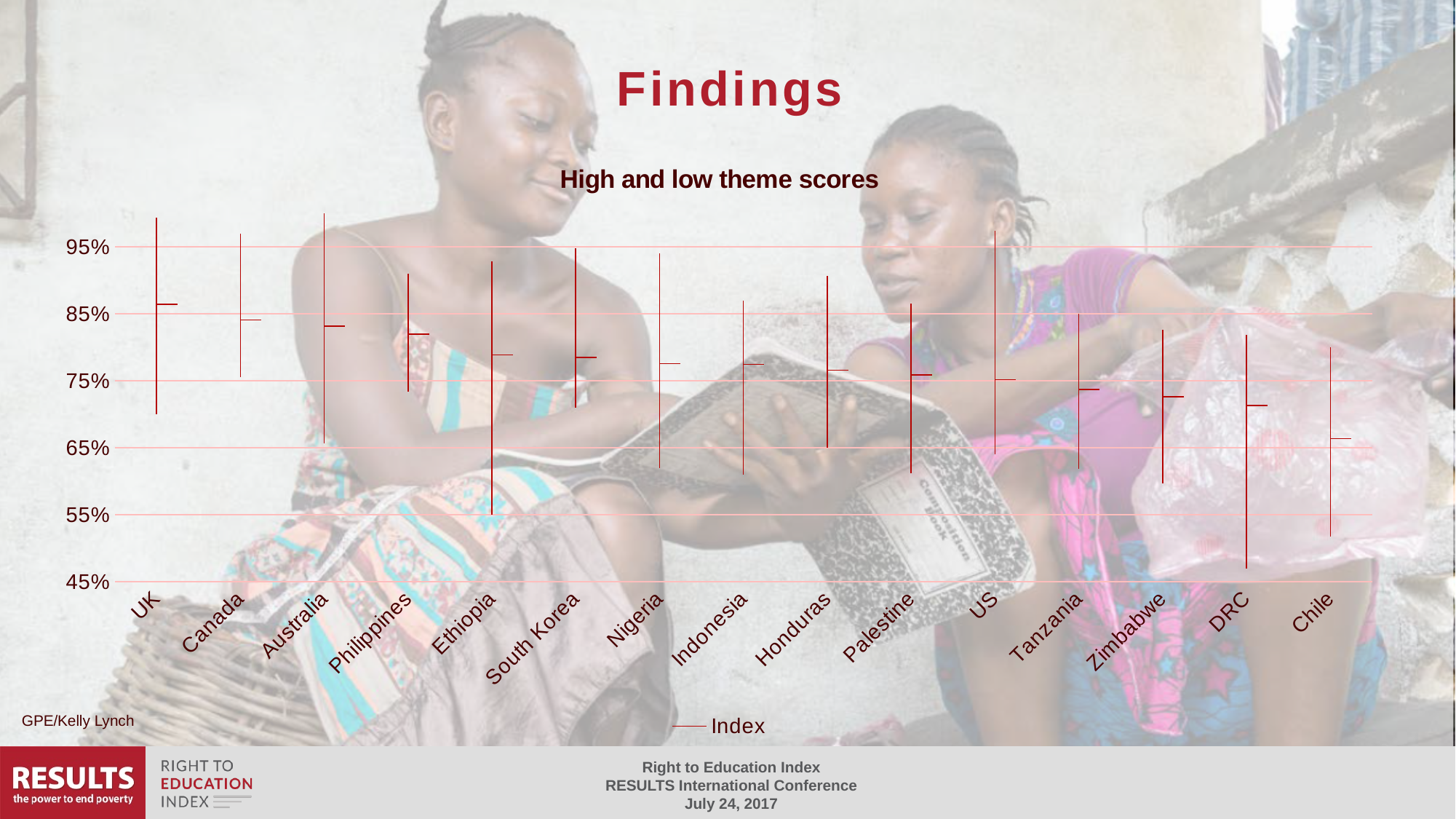
How many series does the chart legend list? 1 What is the name of the series shown in the chart legend? Index How many countries are shown on the x axis of the chart? 15 Is the low theme score for Ethiopia greater or less than 65%? less Is the Index value for UK greater or less than 75%? greater What is the title of the chart? High and low theme scores What kind of chart is shown on the slide? high-low (stock) chart Which has the higher Index value, Canada or DRC? Canada Is the Index value for Chile greater or less than 75%? less Which country has the lowest Index value in the chart? Chile Which country has the lowest low theme score in the chart? DRC Do the Index values generally rise or fall moving from UK on the left to Chile on the right? fall